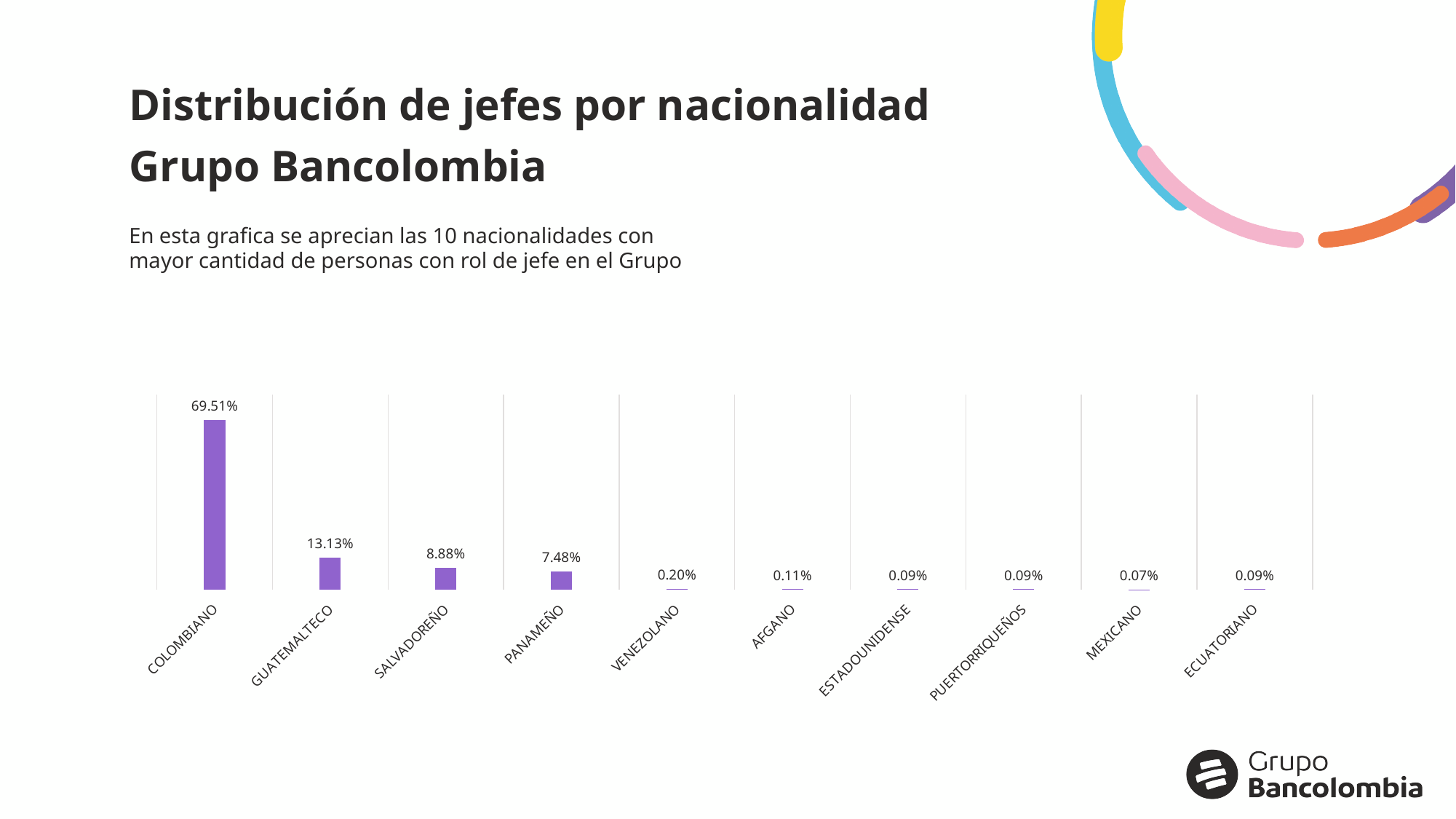
What is the value for VENEZOLANO? 0.20% What is the difference between the values for SALVADOREÑO and PANAMEÑO? 1.40% How many nationalities are shown in the chart? 10 What is the value for SALVADOREÑO? 8.88% What is the value for GUATEMALTECO? 13.13% What is the difference between the values for COLOMBIANO and GUATEMALTECO? 56.38% What is the value for COLOMBIANO? 69.51% Which is larger, the value for PANAMEÑO or the value for SALVADOREÑO? SALVADOREÑO What is the value for MEXICANO? 0.07% Which nationality has the lowest value? MEXICANO What kind of chart is shown on the slide? Bar chart Which nationality has the highest value? COLOMBIANO